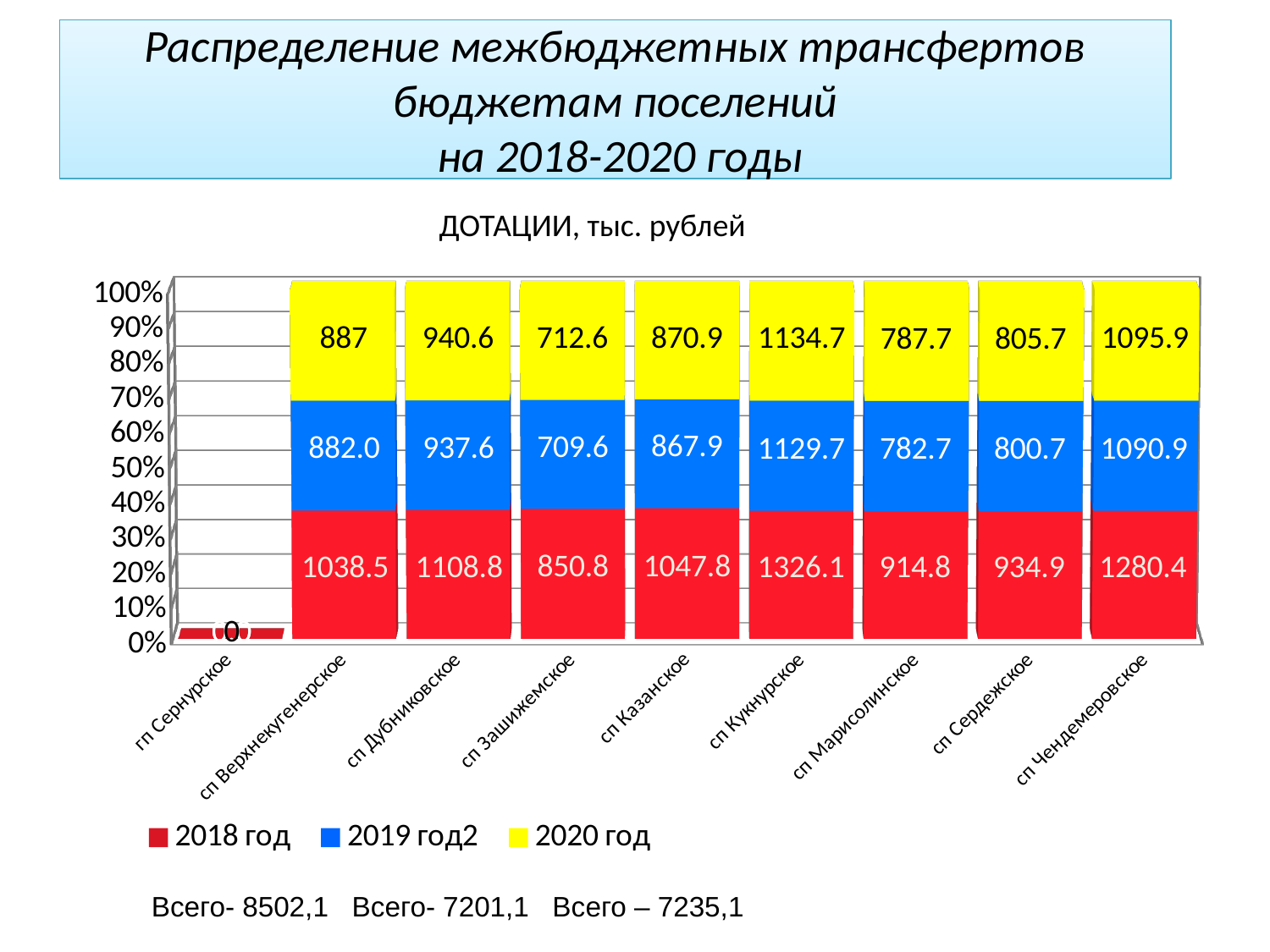
How many series does the legend list? 3 What is the 2020 год value for сп Чендемеровское? 1095.9 What kind of chart is shown? Stacked bar chart How many categories are shown on the x axis? 9 Which has the larger 2019 год2 value, сп Дубниковское or сп Марисолинское? сп Дубниковское What is the 2018 год value for гп Сернурское? 0 What is the total of the three series values for сп Верхнекугенерское? 2807.5 Which category has the highest 2018 год value? сп Кукнурское What is the 2018 год value for сп Кукнурское? 1326.1 Which category has the highest 2020 год value? сп Кукнурское What is the difference between the 2018 год values for сп Кукнурское and сп Чендемеровское? 45.7 What is the 2019 год2 value for сп Зашижемское? 709.6